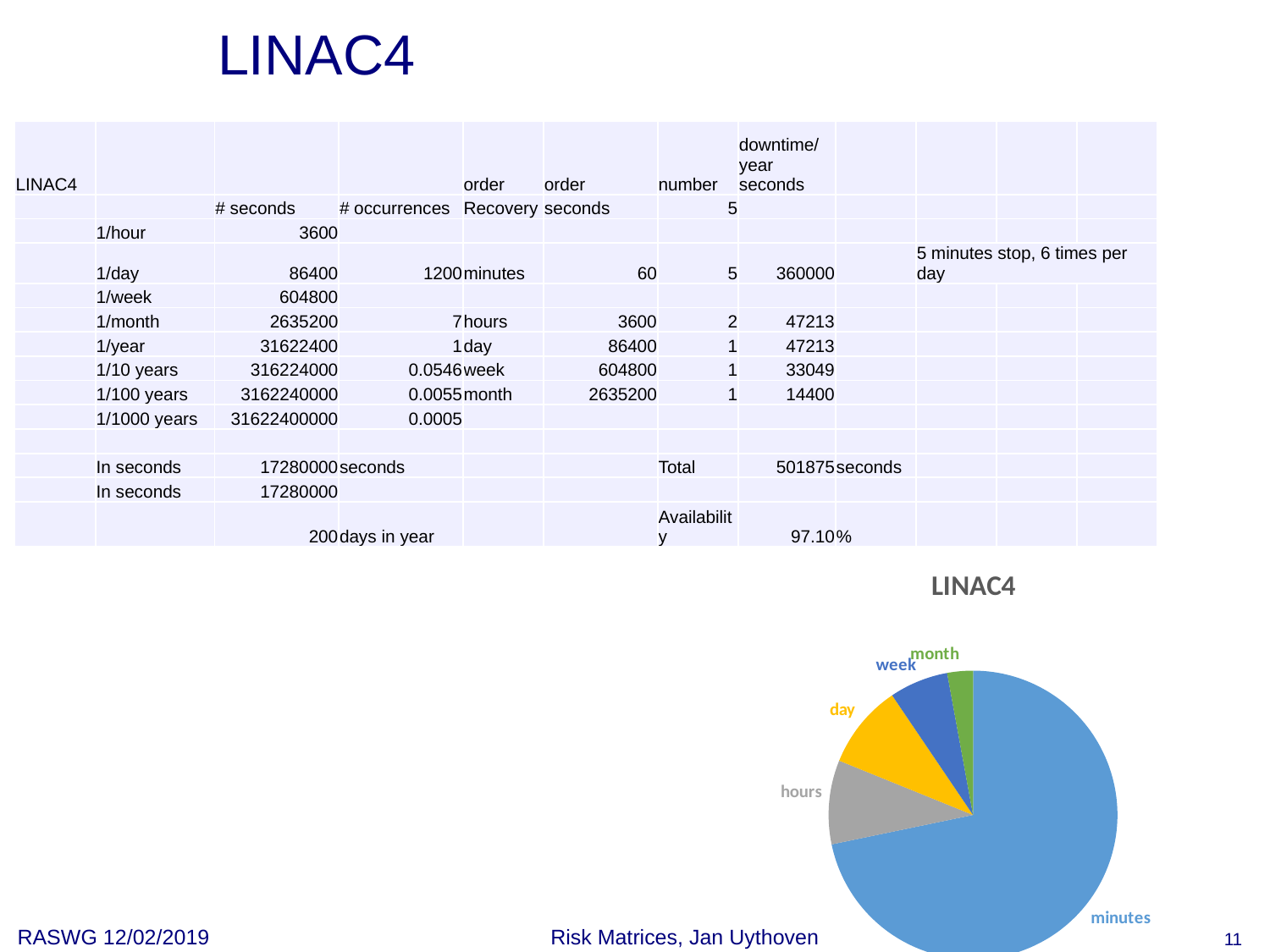
What is the title of the pie chart? LINAC4 What kind of chart is shown on the slide? pie chart In the pie chart, which slice is larger, week or month? week What colour is the minutes slice in the pie chart? blue In the pie chart, which slice is larger, minutes or hours? minutes How many slices does the pie chart have? 5 Does the minutes slice take up more or less than half of the pie chart? more In the pie chart, which slice is larger, day or month? day Which slice of the pie chart is the largest? minutes Which slice of the pie chart is the smallest? month